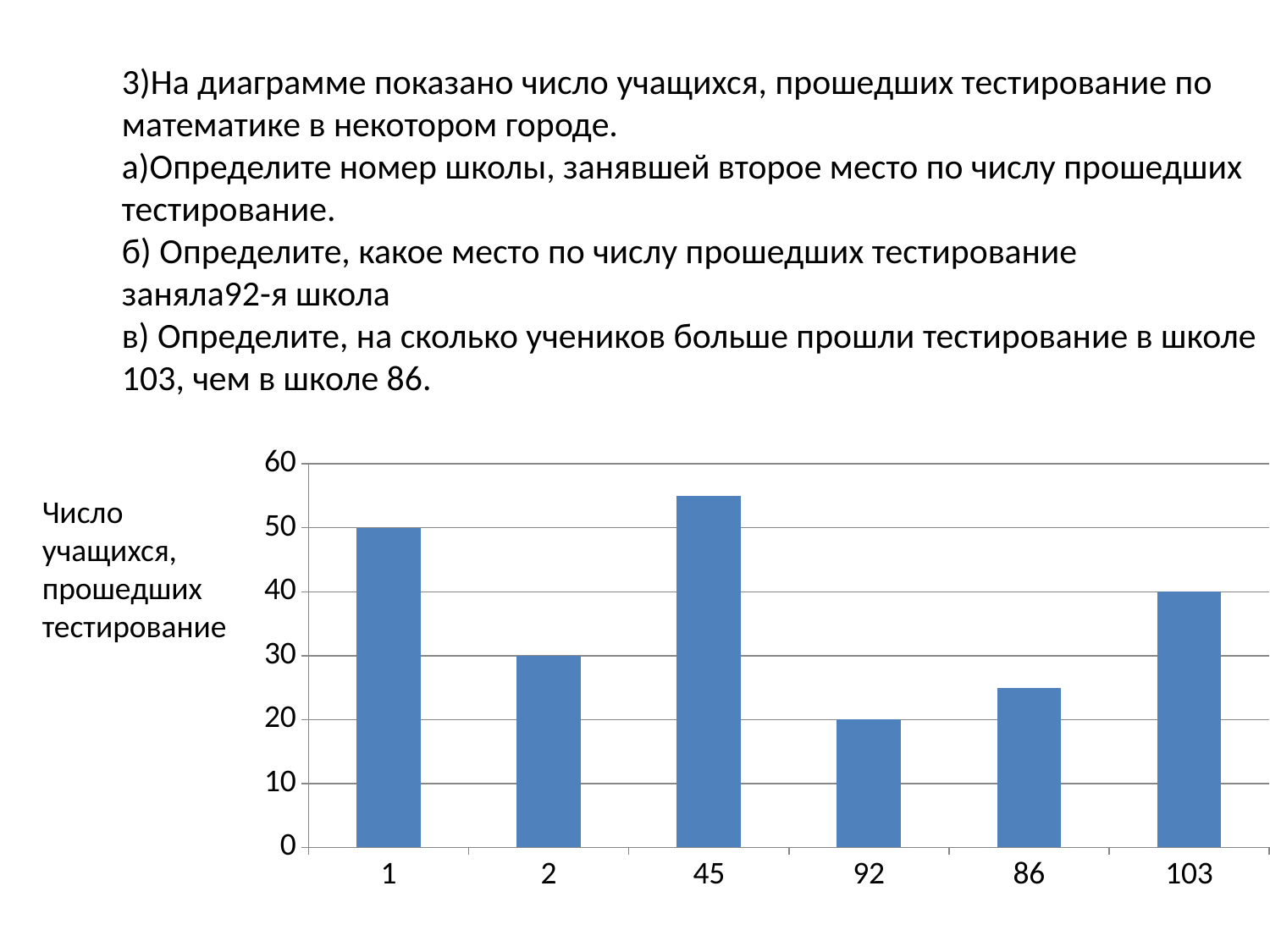
Which has a larger value, school 86 or school 103? 103 Which school has the lowest number of students who passed the test? 92 What is the difference between the values for school 103 and school 2? 10 What is the number of students who passed the test for school 1? 50 Which school has the highest number of students who passed the test? 45 Is the value for school 86 greater or less than 30? less What is the difference between the values for school 1 and school 92? 30 Is the value for school 45 greater or less than 50? greater What is the value shown for school 2? 30 What is the value shown for school 103? 40 What is the value shown for school 92? 20 How many schools are shown on the chart? 6